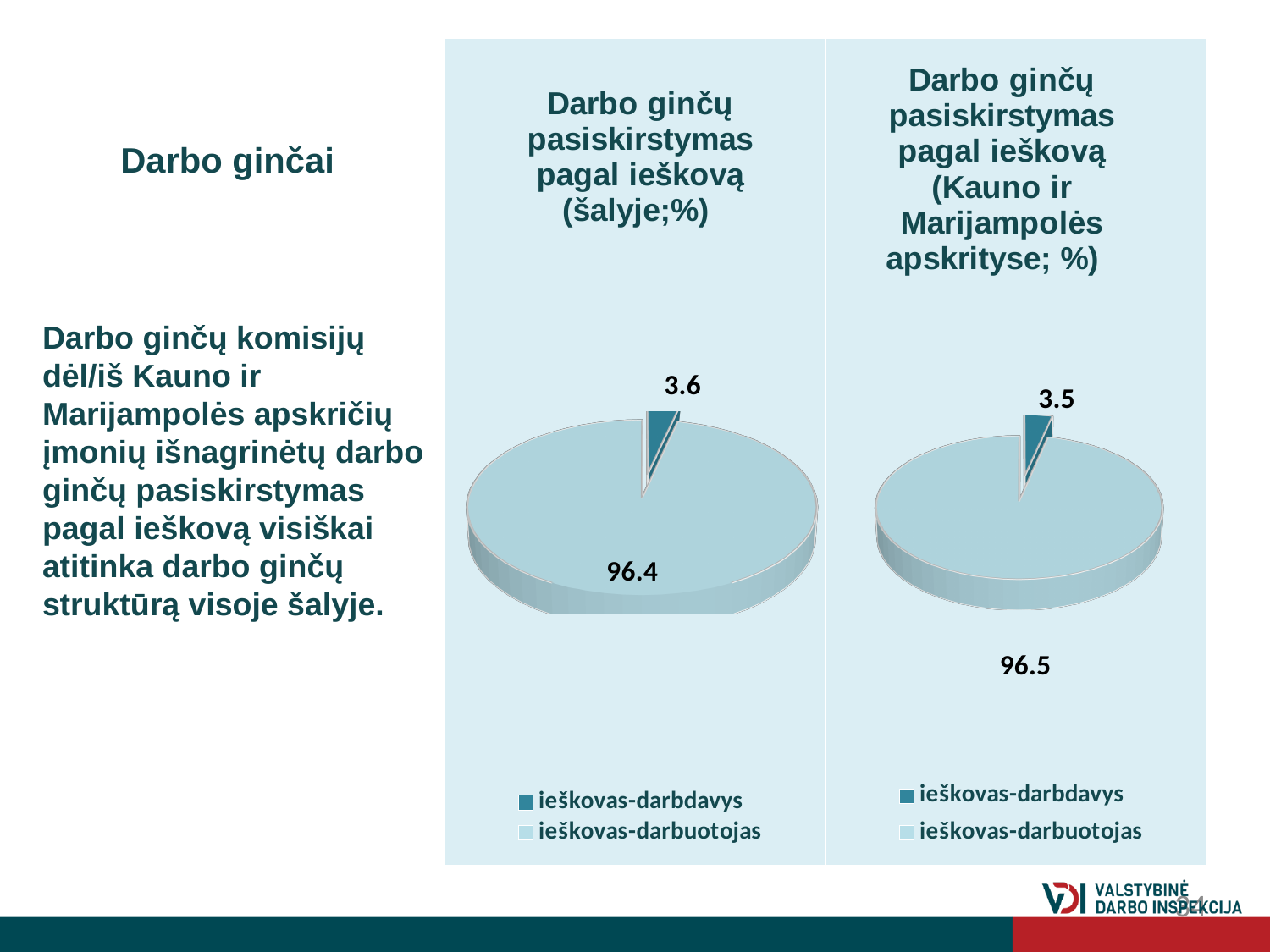
In the left chart (šalyje), what is the value for ieškovas-darbuotojas? 96.4 How many slices does the right chart (Kauno ir Marijampolės apskrityse) have? 2 In the left chart (šalyje), what is the difference between the ieškovas-darbuotojas and ieškovas-darbdavys values? 92.8 In the right chart (Kauno ir Marijampolės apskrityse), which category has the smallest slice? ieškovas-darbdavys How many pie charts are shown on the slide? 2 What type of chart is used on this slide? pie chart In the left chart (šalyje), which category has the largest slice? ieškovas-darbuotojas In the right chart (Kauno ir Marijampolės apskrityse), what is the value for ieškovas-darbuotojas? 96.5 In the left chart (šalyje), what is the value for ieškovas-darbdavys? 3.6 In the right chart (Kauno ir Marijampolės apskrityse), what is the value for ieškovas-darbdavys? 3.5 How many entries does the legend of the left chart (šalyje) list? 2 Which is larger: the ieškovas-darbdavys value in the left chart (šalyje) or in the right chart (Kauno ir Marijampolės apskrityse)? left chart (šalyje)